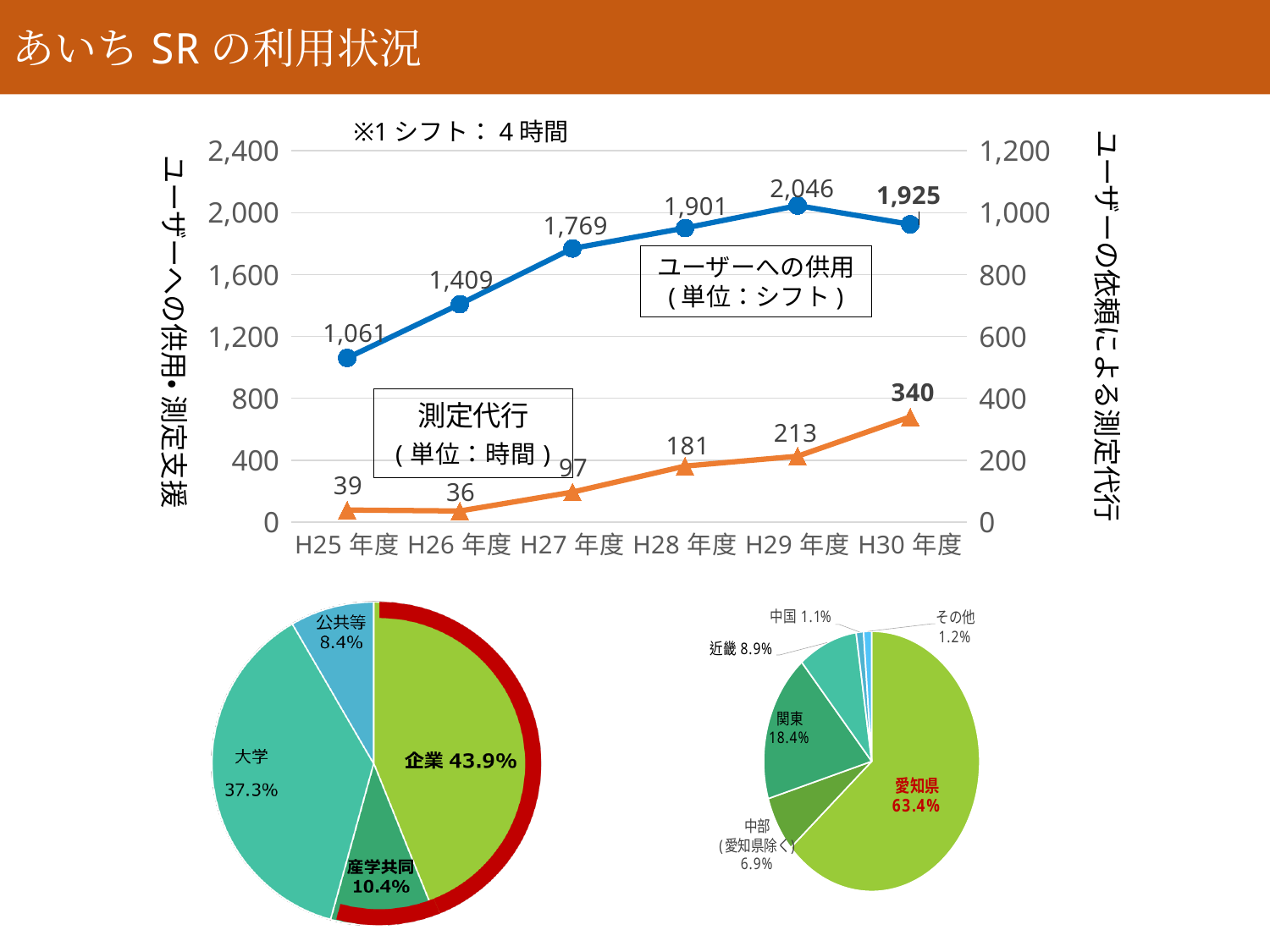
In the top line chart, what is the difference between the ユーザーへの供用 values for H29年度 and H30年度? 121 In the bottom-right pie chart, what share does 関東 have? 18.4% In the top line chart, what is the value of ユーザーへの供用 for H27年度? 1,769 In the top line chart, in which year is 測定代行 lowest? H26年度 What type of chart is the top chart on the slide? line chart In the bottom-left pie chart, which category has the largest share? 企業 In the bottom-right pie chart, which is larger, 近畿 or 中部(愛知県除く)? 近畿 In the top line chart, what is the value of 測定代行 for H30年度? 340 In the top line chart, does 測定代行 generally rise or fall from H25年度 to H30年度? rise In the top line chart, how many years are shown on the x axis? 6 In the bottom-left pie chart, what share does 大学 have? 37.3% In the top line chart, in which year is ユーザーへの供用 highest? H29年度